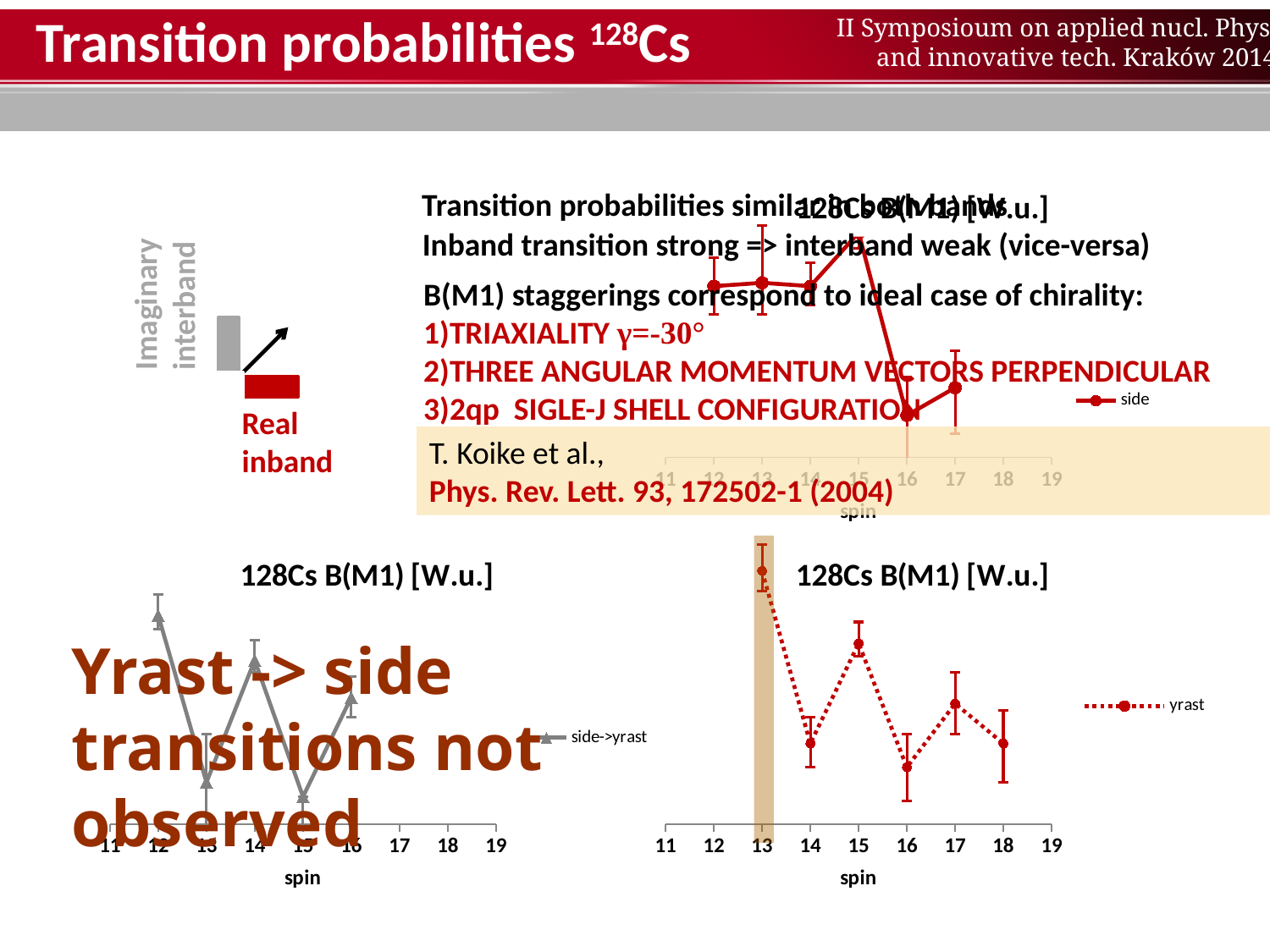
In the bottom-right chart, what series name does the legend show? yrast In the bottom-right chart (yrast), at which spin is the B(M1) value highest? 13 How many series does the legend of the top-right chart list? 1 In the bottom-right chart (yrast), which spin has the larger value, 14 or 15? 15 What kind of chart is the bottom-right chart titled 128Cs B(M1) [W.u.]? line chart In the top-right chart (side), at which spin is the B(M1) value lowest? 16 In the bottom-left chart, what series name does the legend show? side->yrast In the bottom-right chart (yrast), does the value rise or fall from spin 13 to spin 14? fall How many data points are plotted in the bottom-right chart (yrast)? 6 In the top-right chart (side), at which spin is the B(M1) value highest? 15 In the bottom-right chart (yrast), at which spin is the B(M1) value lowest? 16 In the bottom-left chart (side->yrast), at which spin is the B(M1) value highest? 12